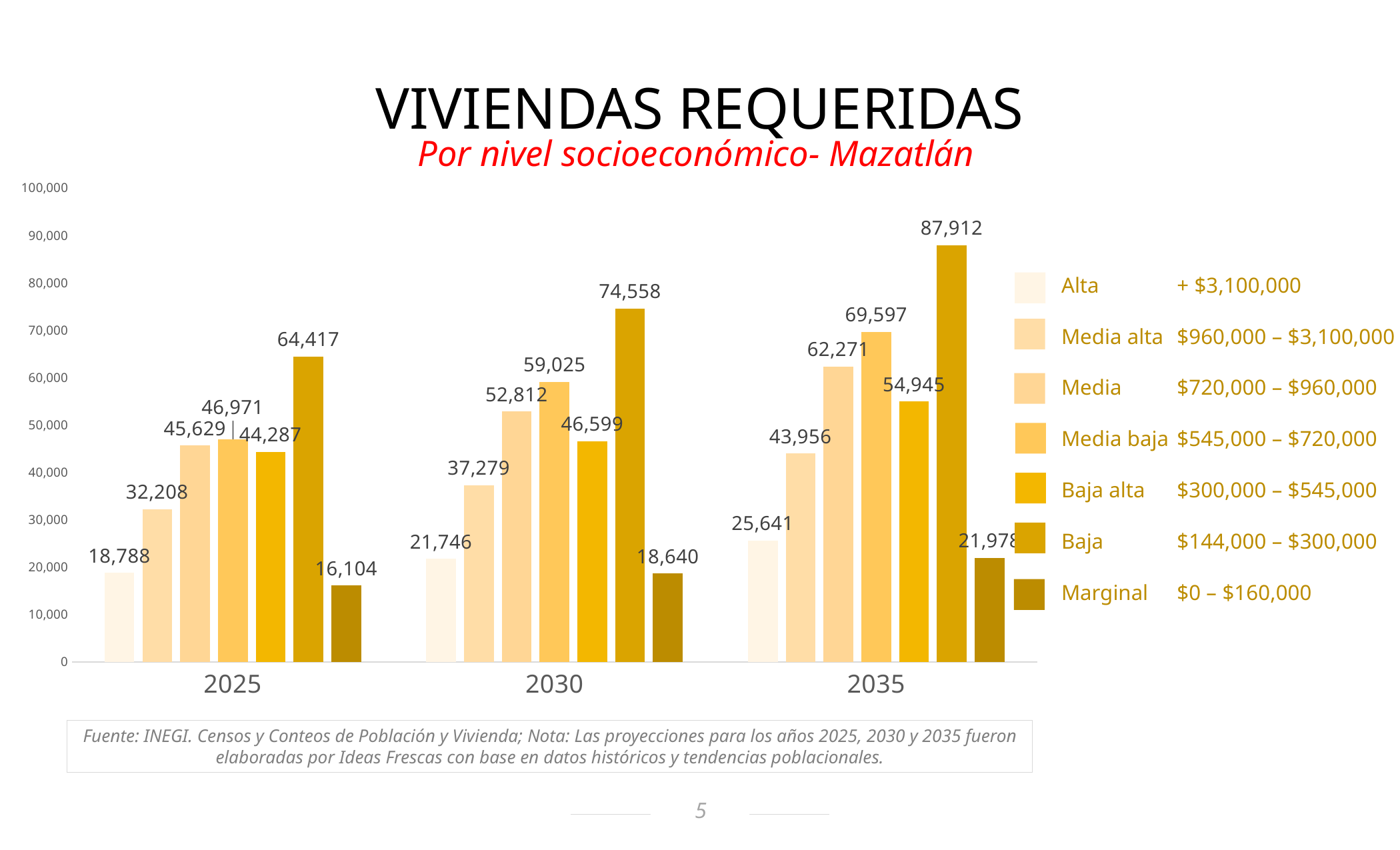
What is the value for Media baja in 2030? 59,025 What type of chart is shown on the slide? bar chart Which is larger in 2035, Media or Baja alta? Media What is the difference between the Baja values for 2035 and 2025? 23,495 What price range does the legend give for the Media baja level? $545,000 – $720,000 Does the value for Baja in 2030 rise or fall compared with 2025? rise How many year categories are shown on the x axis? 3 What is the value for Alta in 2025? 18,788 How many series does the legend list? 7 Which series has the highest value in 2030? Baja What is the value for Baja in 2035? 87,912 Which series has the lowest value in 2025? Marginal